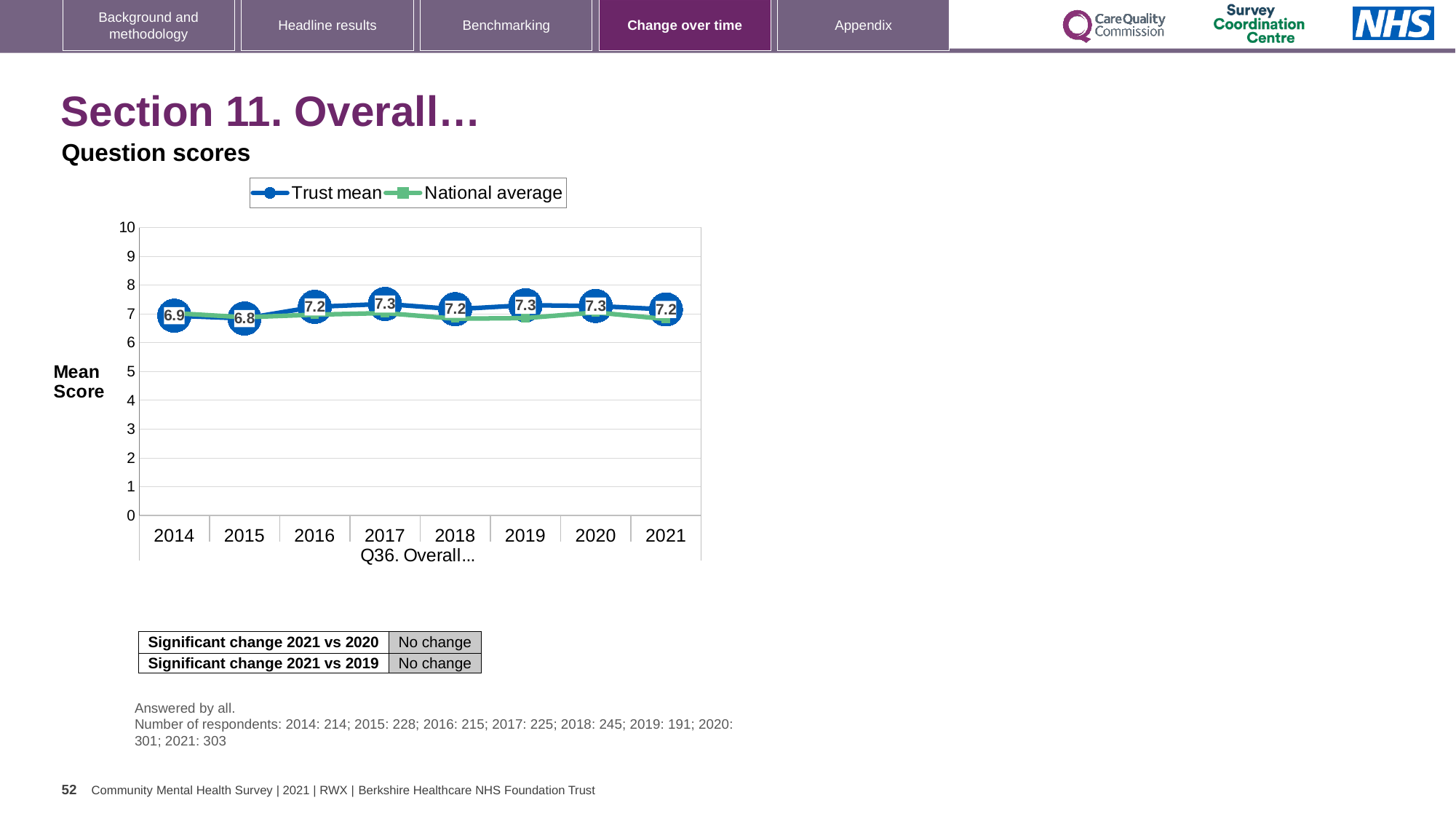
Which is larger, the Trust mean for 2016 or for 2019? 2019 Does the Trust mean rise or fall from 2015 to 2017? Rise How many years are shown on the x axis? 8 In which year is the Trust mean lowest? 2015 What is the Trust mean for 2017? 7.3 What is the label on the y axis? Mean Score What is the difference between the Trust mean in 2021 and in 2015? 0.4 What is the Trust mean for 2014? 6.9 What is the Trust mean for 2021? 7.2 Is the National average for 2018 greater or less than 5? greater How many series does the legend list? 2 What kind of chart is shown? Line chart